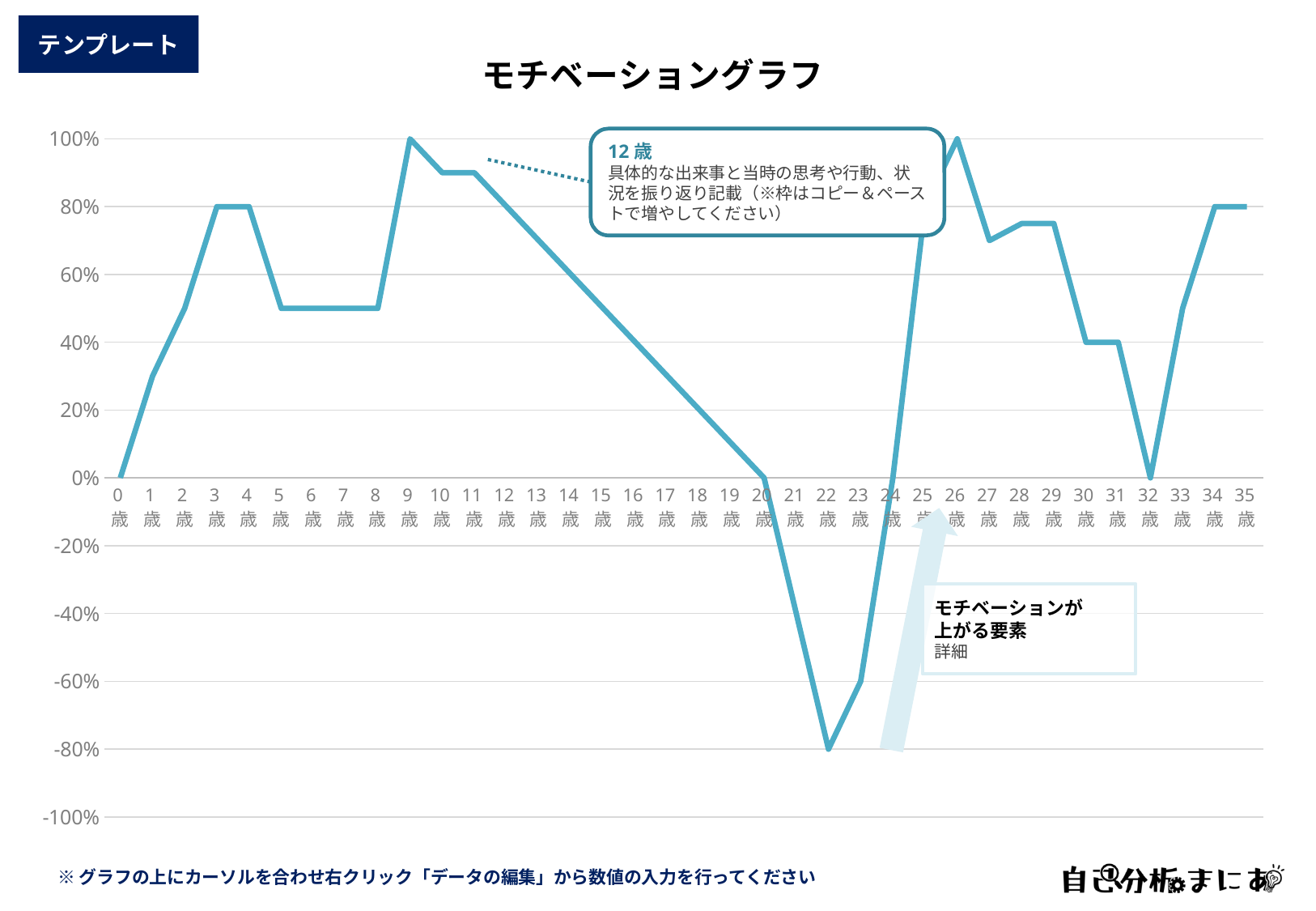
What is the value at 32歳? 0% What is the highest value reached on the chart? 100% What is the value at 9歳? 100% What is the difference between the value at 9歳 and the value at 22歳? 180% Is the value at 27歳 greater or less than 60%? greater What is the value at 23歳? -60% What is the title of the chart? モチベーショングラフ How many age points are plotted along the x axis? 36 What kind of chart is shown on the slide? line chart Which is larger, the value at 3歳 or the value at 30歳? 3歳 What is the value at 22歳? -80% At which age is the motivation value lowest? 22歳